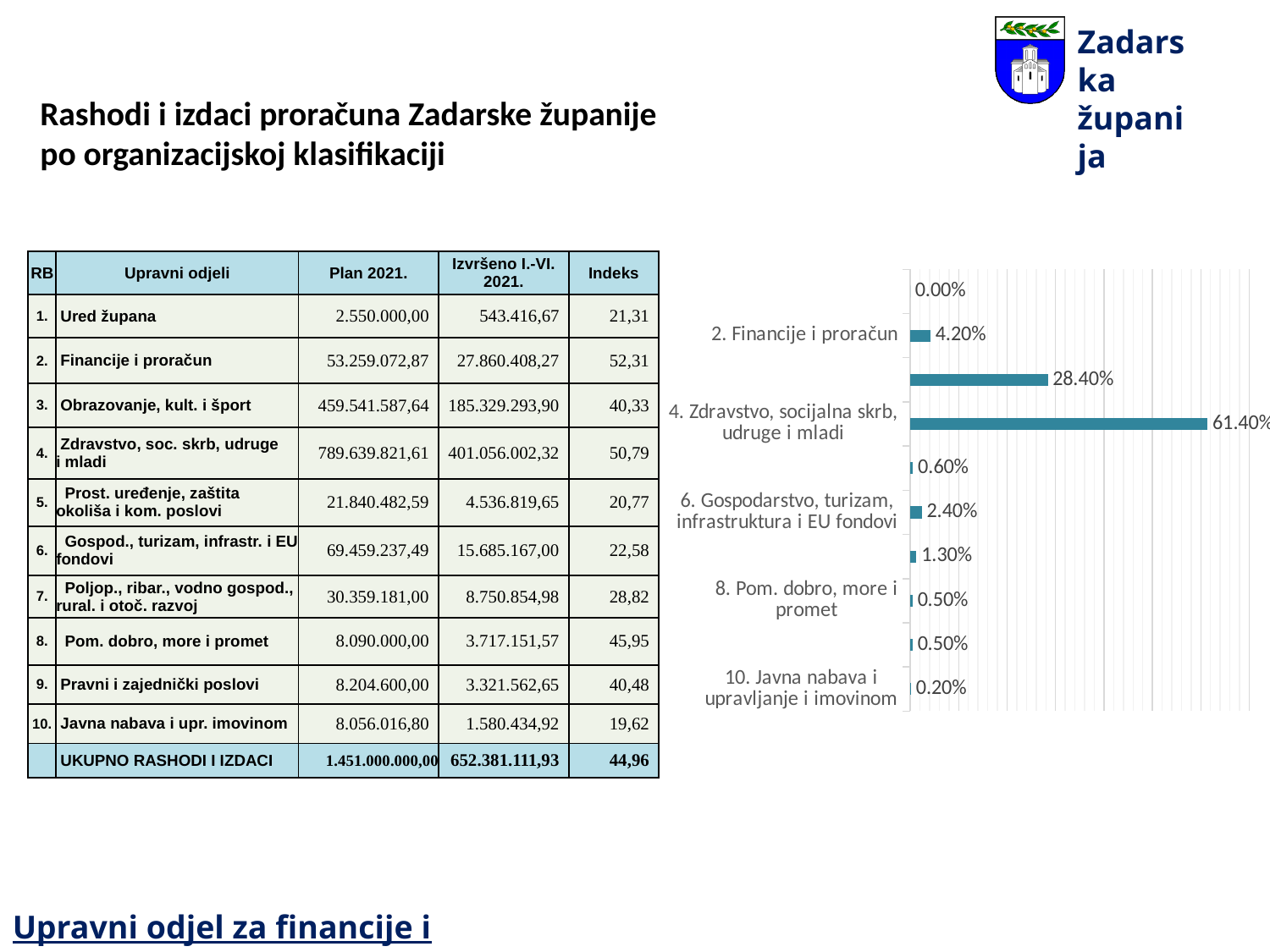
Which category has the highest value in the bar chart? 4. Zdravstvo, socijalna skrb, udruge i mladi Which has a larger value in the bar chart: "2. Financije i proračun" or "6. Gospodarstvo, turizam, infrastruktura i EU fondovi"? 2. Financije i proračun Which has a larger value in the bar chart: "8. Pom. dobro, more i promet" or "10. Javna nabava i upravljanje i imovinom"? 8. Pom. dobro, more i promet What kind of chart is shown on the right side of the slide? Bar chart What is the value shown for "8. Pom. dobro, more i promet" in the bar chart? 0.50% What is the difference between the values for "4. Zdravstvo, socijalna skrb, udruge i mladi" and "2. Financije i proračun" in the bar chart? 57.20% What is the value shown for "6. Gospodarstvo, turizam, infrastruktura i EU fondovi" in the bar chart? 2.40% What is the difference between the values for "6. Gospodarstvo, turizam, infrastruktura i EU fondovi" and "8. Pom. dobro, more i promet" in the bar chart? 1.90% What is the value shown for "4. Zdravstvo, socijalna skrb, udruge i mladi" in the bar chart? 61.40% How many bars are plotted in the bar chart? 10 What is the value shown for "10. Javna nabava i upravljanje i imovinom" in the bar chart? 0.20% What is the value shown for "2. Financije i proračun" in the bar chart? 4.20%